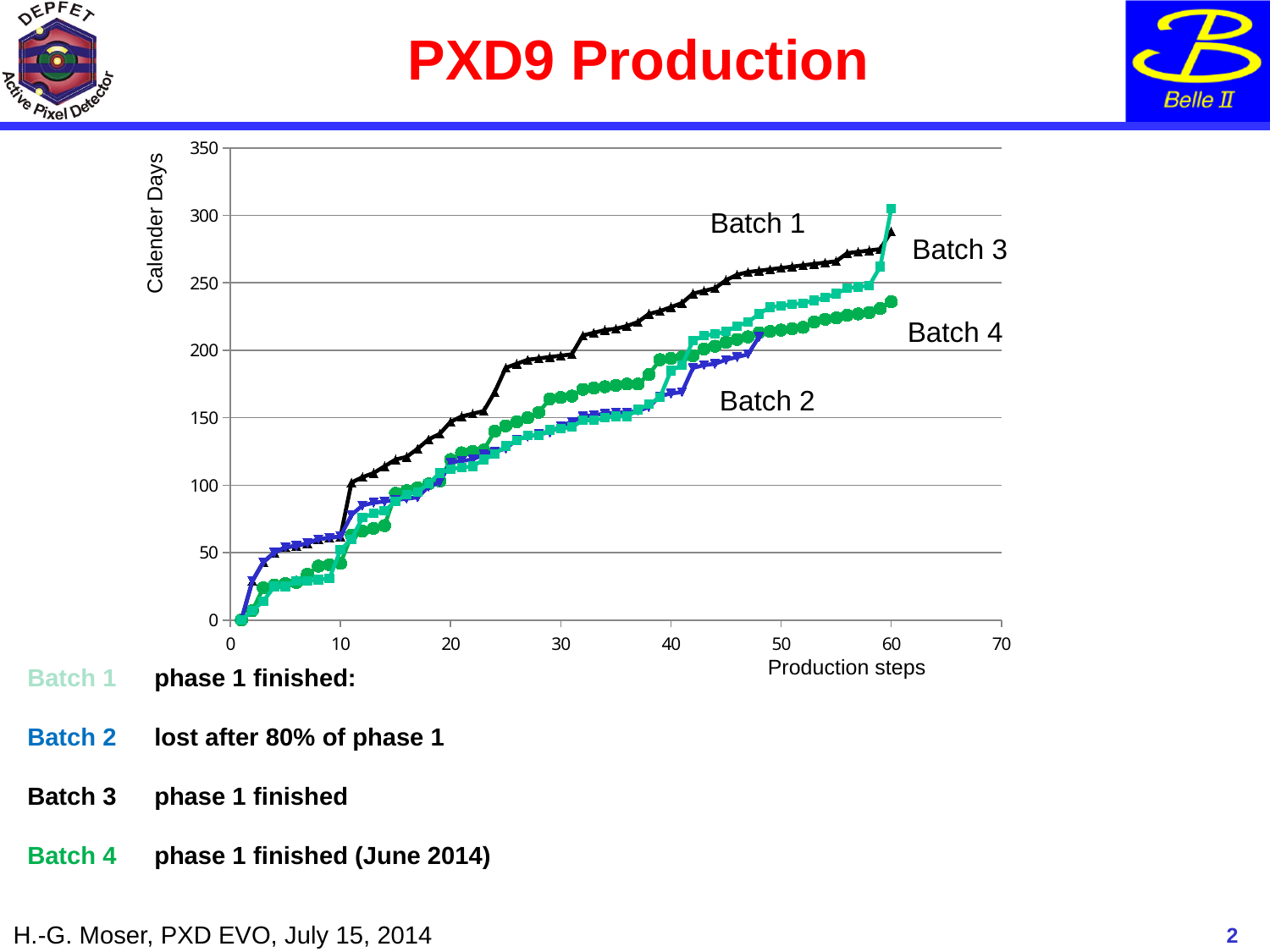
Which batch reaches the highest number of calendar days at the end of its line? Batch 3 At production step 60, which has more calendar days, Batch 3 or Batch 4? Batch 3 How many batch series are plotted in the chart? 4 At production step 60, is the value for Batch 4 greater or less than 250 calendar days? less At production step 30, which has more calendar days, Batch 1 or Batch 4? Batch 1 At production step 60, is the value for Batch 1 greater or less than 250 calendar days? greater Do the calendar days for each batch rise or fall as production steps increase? rise At production step 25, is the value for Batch 1 greater or less than 150 calendar days? greater Which batch's line ends at the fewest production steps? Batch 2 What is the title of the chart's vertical axis? Calender Days What kind of chart is shown on the slide? line chart What is the title of the chart's horizontal axis? Production steps